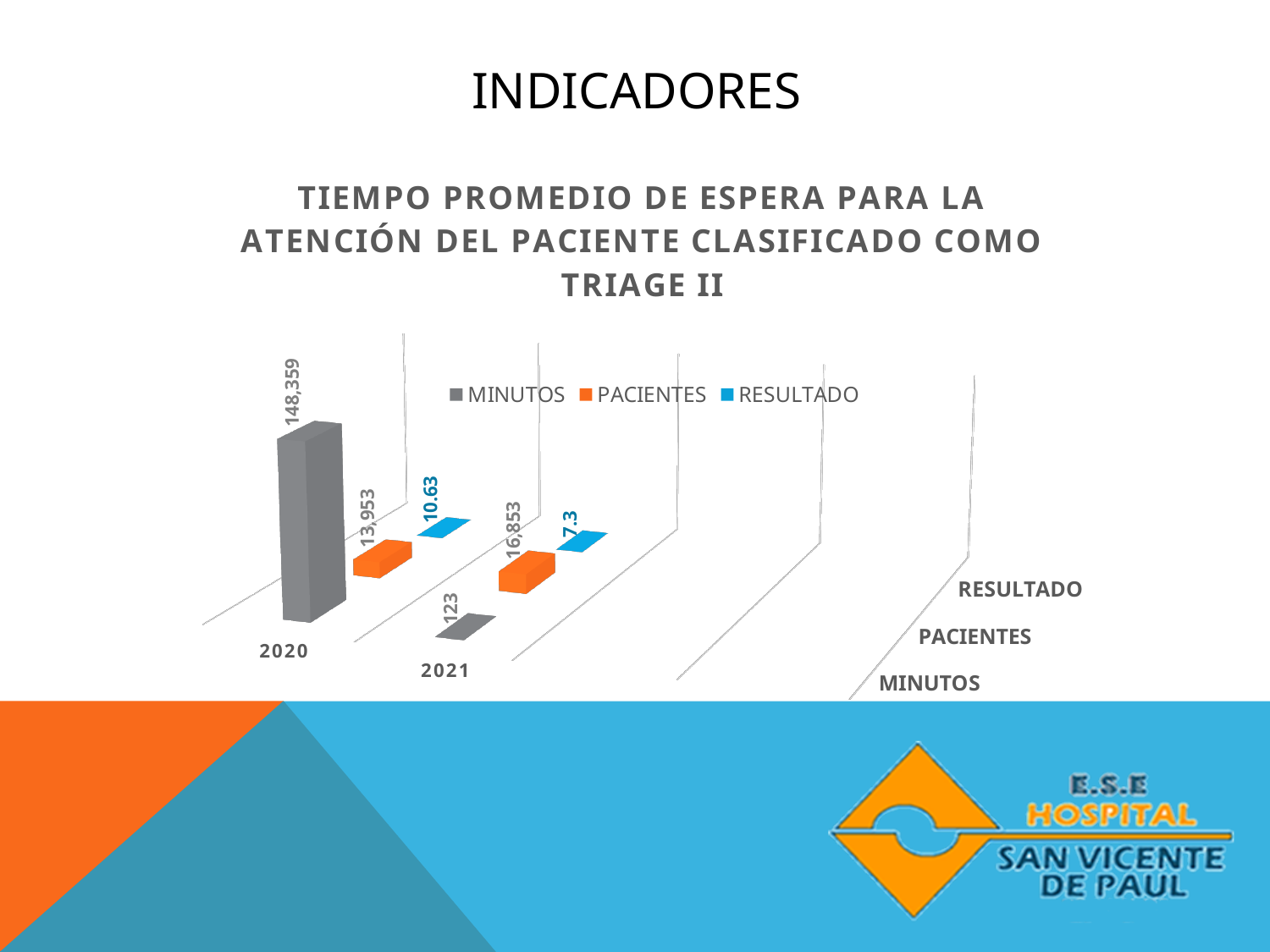
Which year has the lower RESULTADO value? 2021 What is the MINUTOS value for 2020? 148,359 What is the MINUTOS value for 2021? 123 What is the difference between the RESULTADO values for 2020 and 2021? 3.33 What is the RESULTADO value for 2021? 7.3 What is the RESULTADO value for 2020? 10.63 How many series does the legend list? 3 What kind of chart is shown on the slide? Bar chart How many years are shown on the chart? 2 What is the difference between the PACIENTES values for 2021 and 2020? 2,900 Which year has the higher PACIENTES value? 2021 What is the PACIENTES value for 2021? 16,853